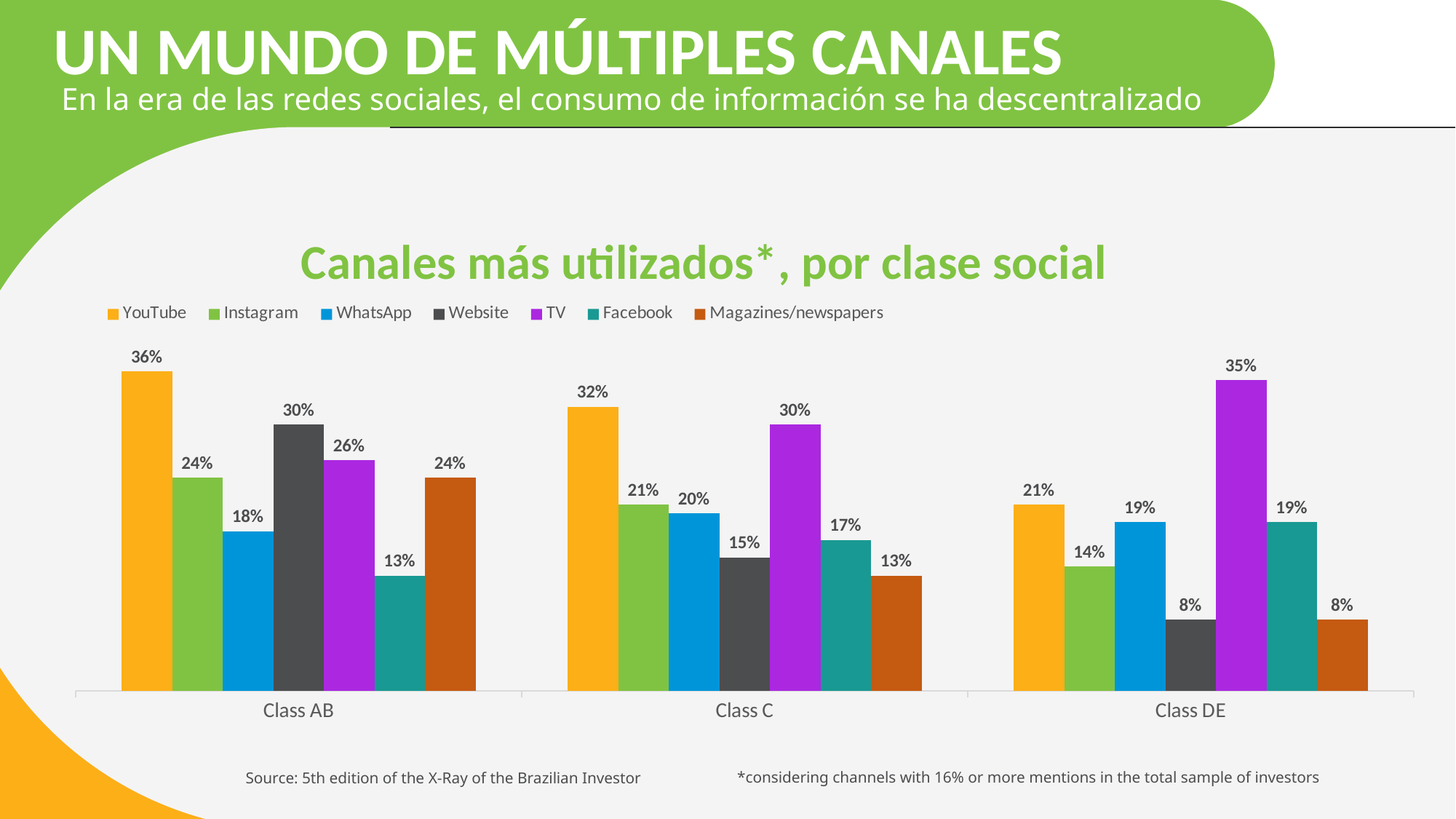
Which channel has the highest value in Class C? YouTube What is the value for YouTube in Class AB? 36% What kind of chart is shown on the slide? Bar chart How many series does the legend list? 7 What is the value for TV in Class DE? 35% What is the value for Website in Class C? 15% How does the value for Website change from Class AB to Class DE? It falls How many social classes are shown on the x axis? 3 What is the title of the chart? Canales más utilizados*, por clase social Which is larger in Class AB: Website or TV? Website Which channel has the lowest value in Class AB? Facebook What is the difference between YouTube and Instagram in Class DE? 7%